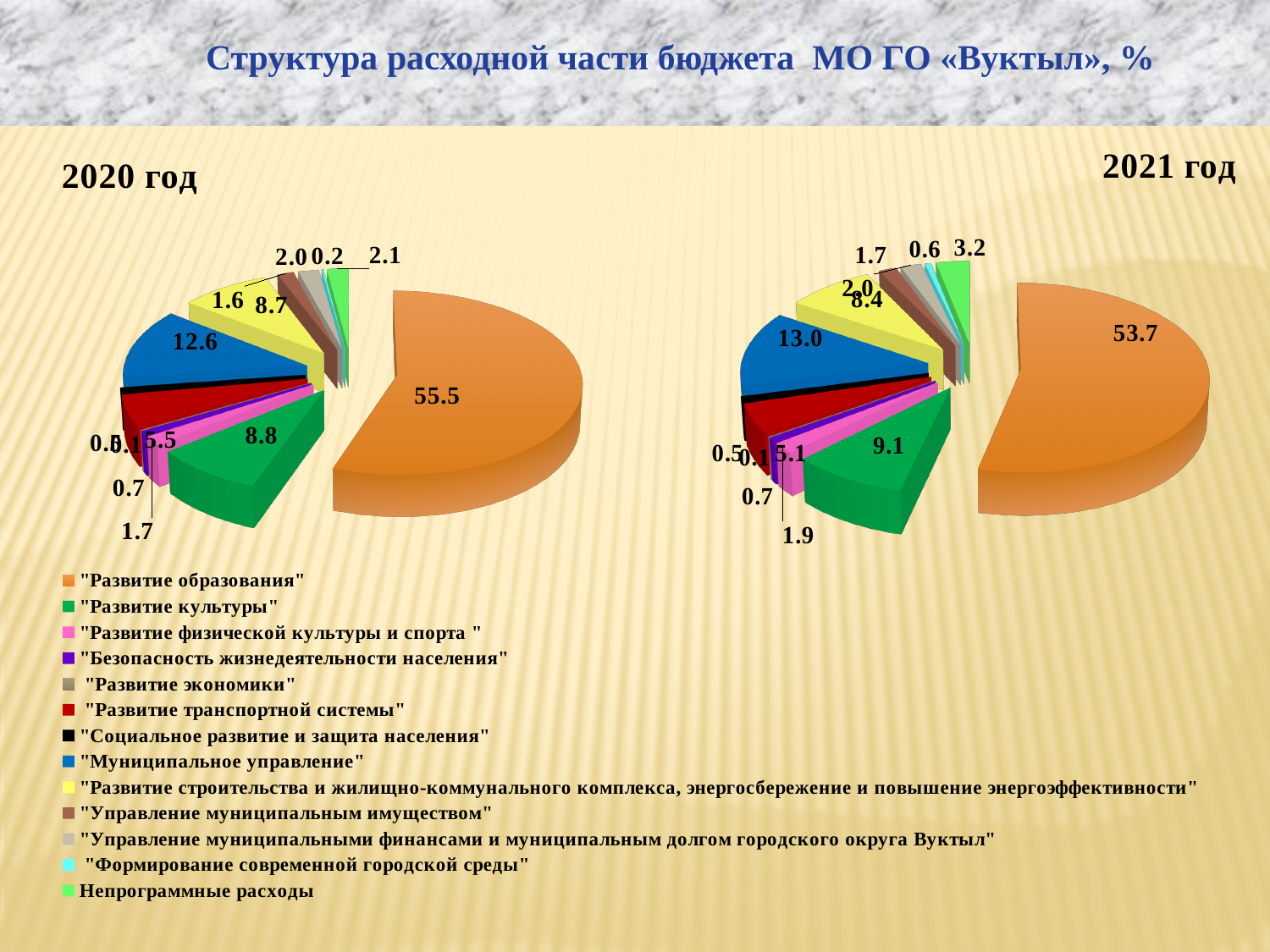
What type of charts are shown on the slide? Pie charts In the 2020 год chart, what is the value for "Муниципальное управление"? 12.6 How many categories does the legend list? 13 In the 2020 год chart, which category has the largest slice? "Развитие образования" In the 2020 год chart, what is the share of "Развитие образования"? 55.5 Which is larger: "Непрограммные расходы" in the 2020 год chart or in the 2021 год chart? 2021 год (3.2) In the 2021 год chart, what is the value for "Муниципальное управление"? 13.0 In the 2021 год chart, what is the value for "Развитие культуры"? 9.1 By how much did the share of "Развитие образования" change from the 2020 год chart to the 2021 год chart? 1.8 In the 2021 год chart, what is the share of "Развитие образования"? 53.7 In the 2020 год chart, what is the value for "Развитие культуры"? 8.8 In the 2021 год chart, what is the value for "Развитие строительства и жилищно-коммунального комплекса, энергосбережение и повышение энергоэффективности"? 8.4